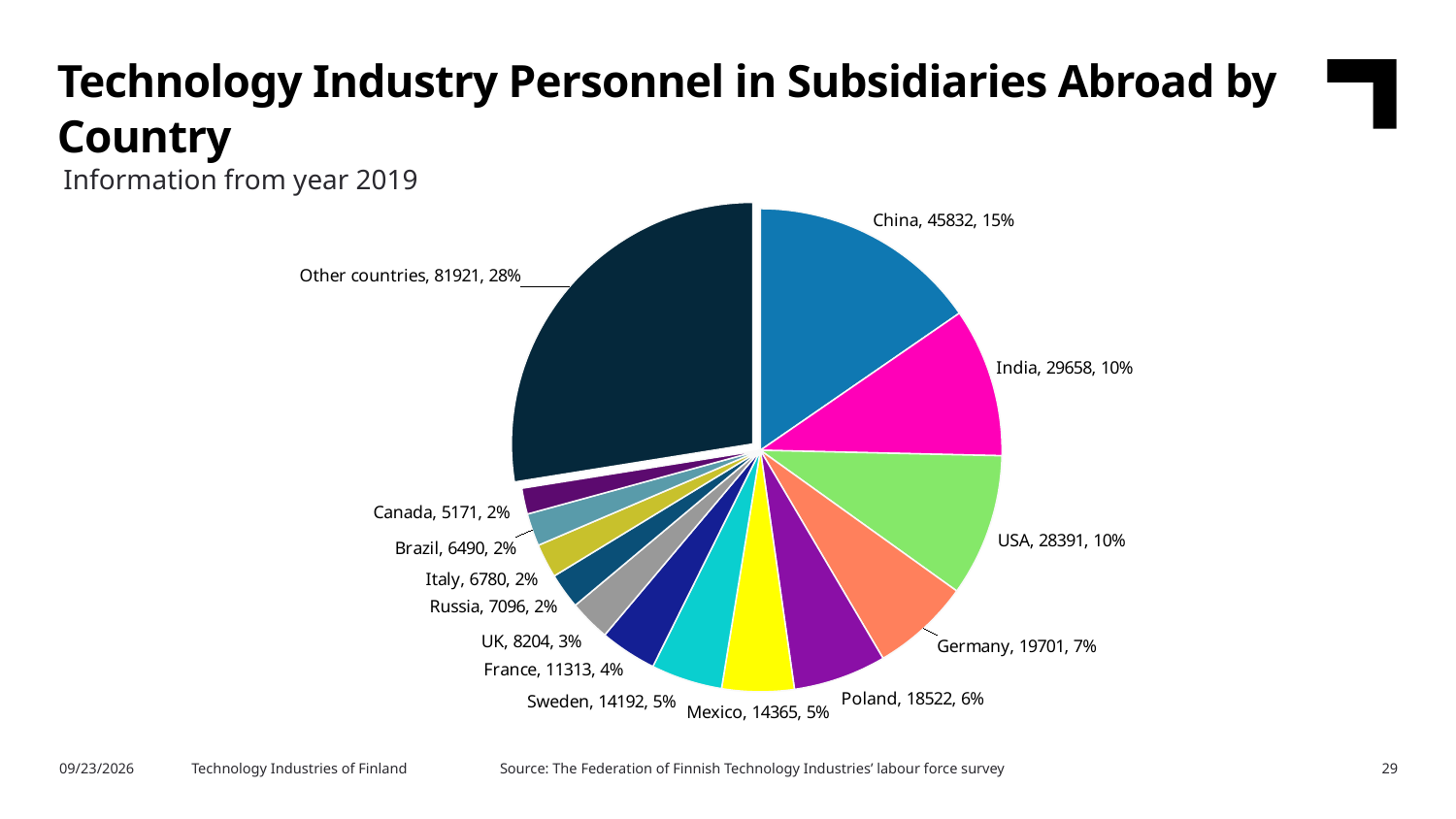
What percentage share does India have in the pie chart? 10% What is the number of personnel in subsidiaries in China? 45832 What type of chart is shown on the slide? Pie chart What is the difference in personnel between the UK and Russia? 1108 What is the difference in personnel between China and India? 16174 What percentage share does Other countries have? 28% Which named country has the smallest number of personnel? Canada Which category has the largest slice of the pie? Other countries How many slices does the pie chart have? 14 What year does the information in the chart come from? 2019 What is the number of personnel for Sweden? 14192 Which has more personnel, Germany or Poland? Germany